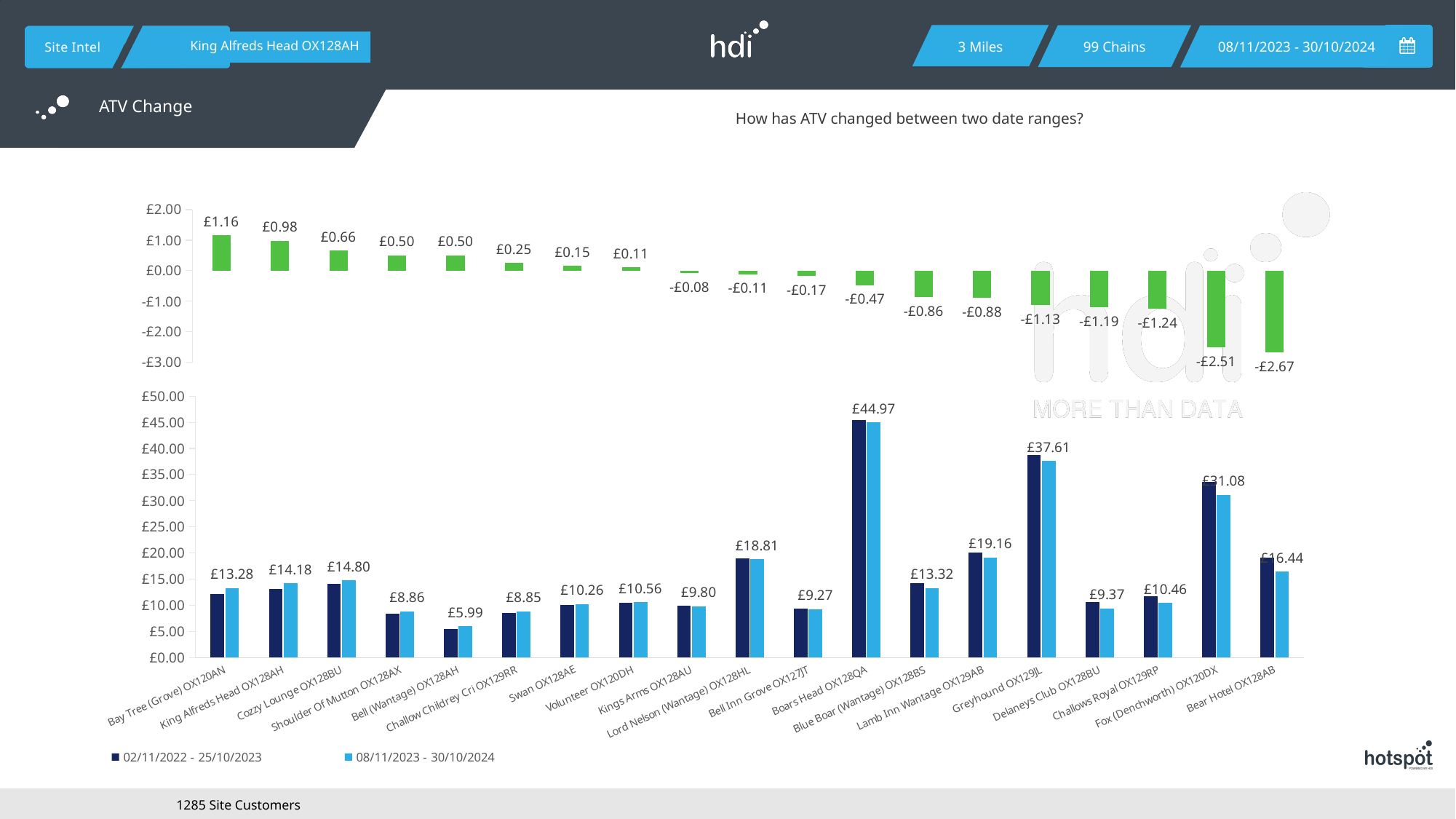
In the top chart, which site has the lowest ATV change? Bear Hotel OX128AB In the bottom chart, what value is labelled for Boars Head OX128QA? £44.97 How many series does the legend of the bottom chart list? 2 In the top chart, which site has the highest ATV change? Bay Tree (Grove) OX120AN How many bars are plotted in the top chart? 19 In the bottom chart, which is larger: the value for Greyhound OX129JL or Fox (Denchworth) OX120DX? Greyhound OX129JL In the top chart, what is the ATV change for Bay Tree (Grove) OX120AN? £1.16 In the top chart, do the values rise or fall from left to right? fall In the bottom chart, what value is labelled for Bell (Wantage) OX128AH? £5.99 In the top chart, what is the difference between the ATV change for Bay Tree (Grove) OX120AN and King Alfreds Head OX128AH? £0.18 What kind of chart is the bottom chart? bar chart In the bottom chart, which site has the highest labelled value? Boars Head OX128QA